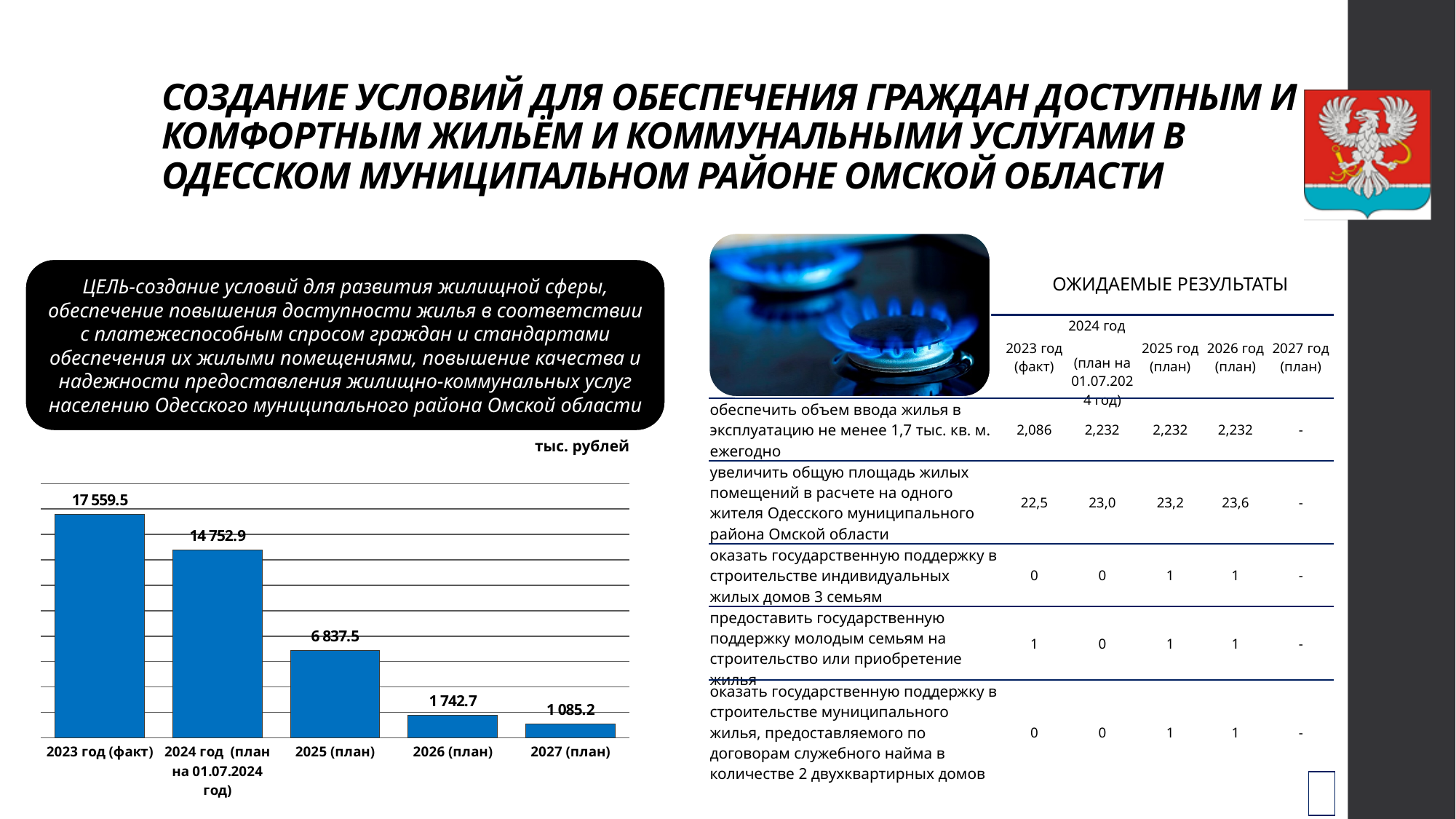
Which category has the lowest value in the bar chart? 2027 (план) Which is larger in the bar chart: the value for 2025 (план) or the value for 2026 (план)? 2025 (план) What is the value for 2027 (план) in the bar chart? 1 085.2 What is the value for 2024 год (план на 01.07.2024 год) in the bar chart? 14 752.9 How many categories (years) are shown in the bar chart? 5 Which category has the highest value in the bar chart? 2023 год (факт) What is the value for 2025 (план) in the bar chart? 6 837.5 What type of chart is shown on the slide? bar chart What is the value for 2026 (план) in the bar chart? 1 742.7 What is the value for 2023 год (факт) in the bar chart? 17 559.5 Do the values in the bar chart rise or fall from 2023 to 2027? fall What is the difference between the values for 2023 год (факт) and 2024 год (план на 01.07.2024 год)? 2 806.6